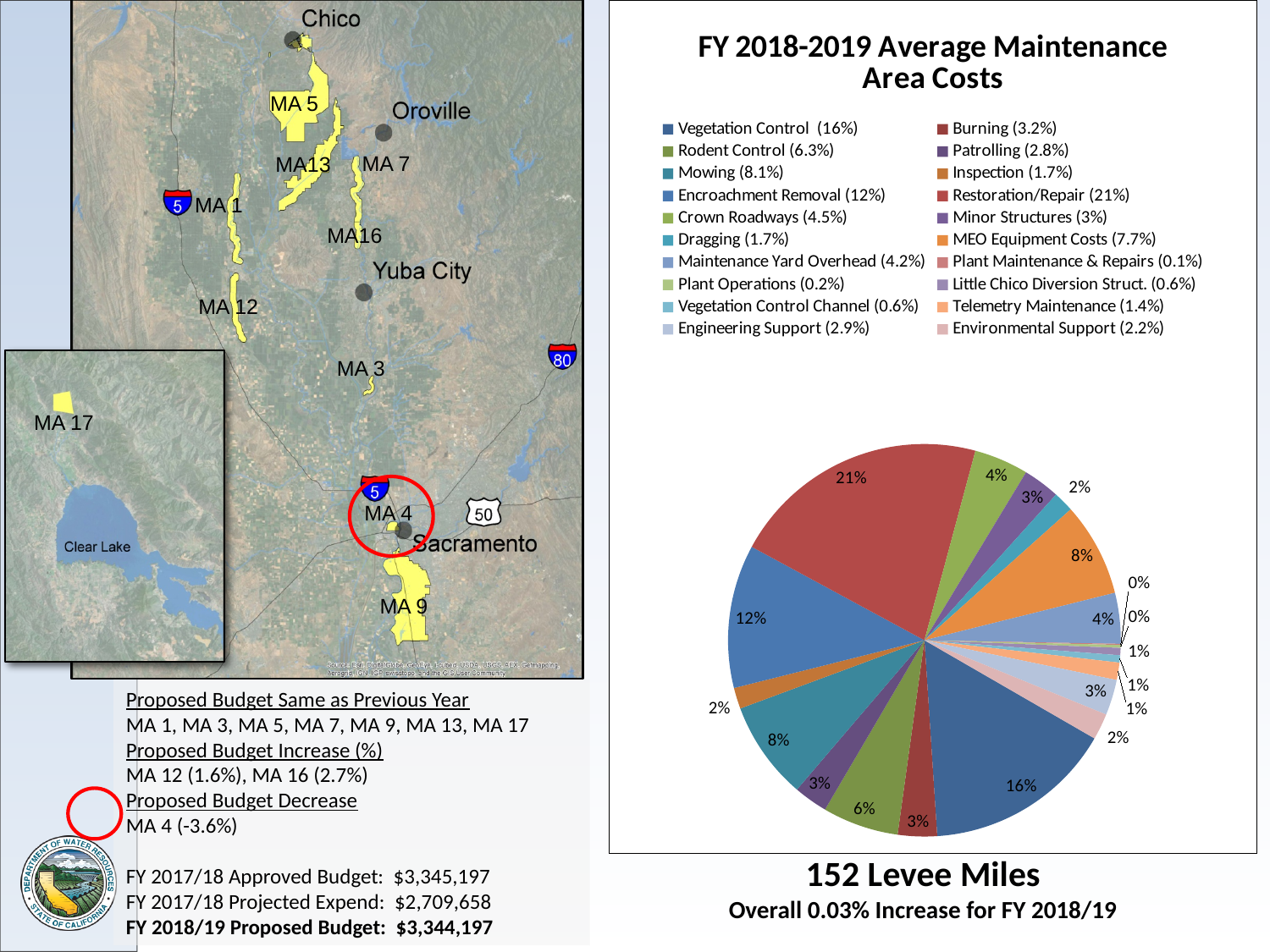
Which category has the largest share of the pie? Restoration/Repair (21%) What is the title of the chart on the slide? FY 2018-2019 Average Maintenance Area Costs What text appears in large bold type directly below the pie chart? 152 Levee Miles According to the legend, what percentage is Mowing? 8.1% What kind of chart is shown on the slide? pie chart How many categories does the chart's legend list? 20 Which has the larger share, Vegetation Control or Encroachment Removal? Vegetation Control By how many percentage points does Restoration/Repair exceed Vegetation Control, using the legend values? 5 percentage points According to the legend, what percentage is Burning? 3.2% According to the legend, what percentage is Encroachment Removal? 12% Which category has the smallest share of the pie? Plant Maintenance & Repairs (0.1%) According to the legend, what percentage is MEO Equipment Costs? 7.7%